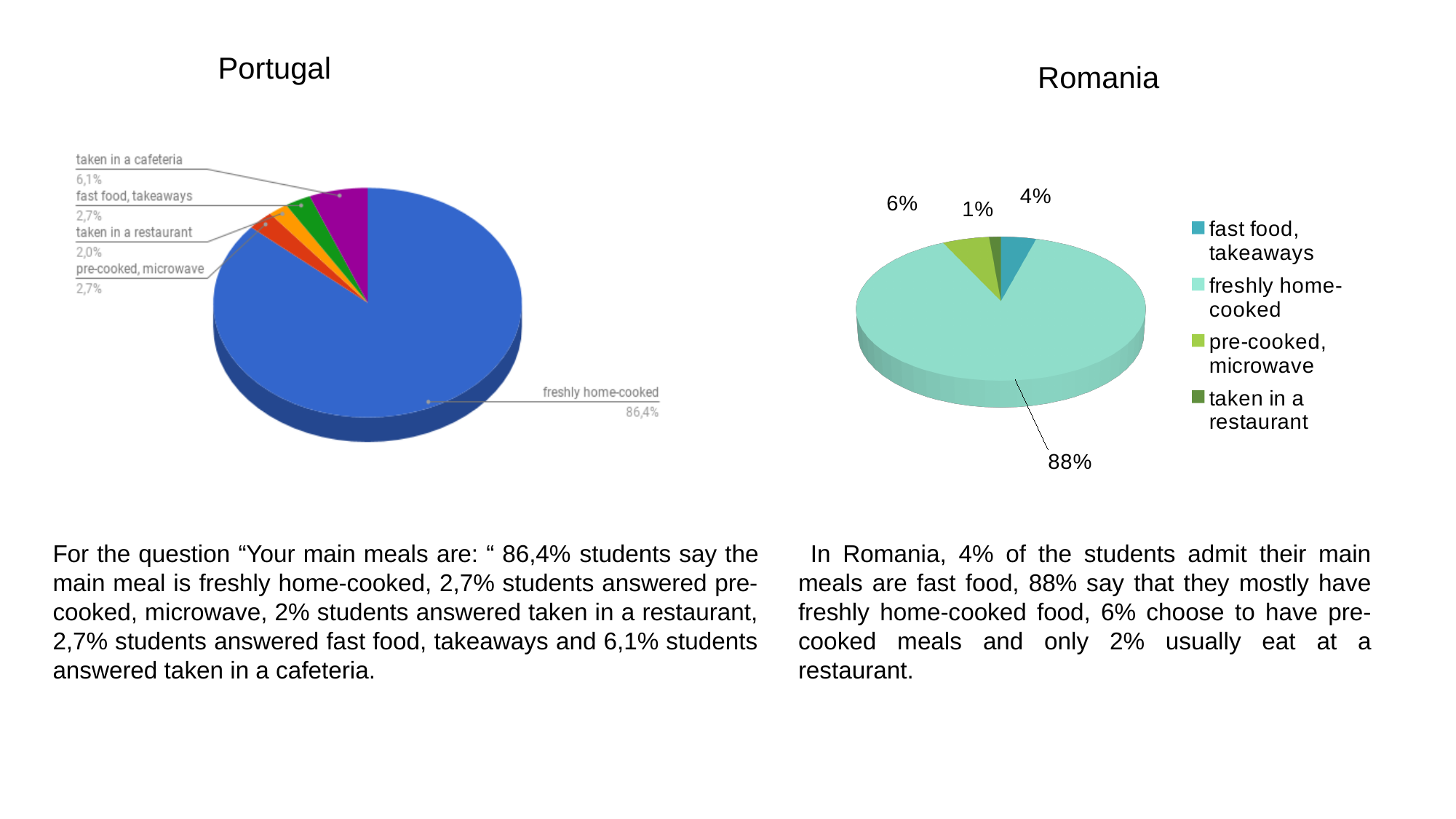
In the Portugal chart, what is the share for 'taken in a cafeteria'? 6,1% In the Romania chart, which is larger: 'fast food, takeaways' or 'pre-cooked, microwave'? pre-cooked, microwave In the Portugal chart, what is the share for 'taken in a restaurant'? 2,0% In the Portugal chart, which category has the largest share? freshly home-cooked How many entries does the legend of the Romania chart list? 4 In the Portugal chart, which category has the smallest share? taken in a restaurant What type of chart is used for Romania? pie chart In the Portugal chart, what is the difference between the shares for 'taken in a cafeteria' and 'fast food, takeaways'? 3,4% In the Portugal chart, what percentage of students say their main meal is freshly home-cooked? 86,4% How many categories are shown in the Portugal pie chart? 5 In the Romania chart, what is the share for 'pre-cooked, microwave'? 6% In the Romania chart, what percentage of students have freshly home-cooked meals? 88%